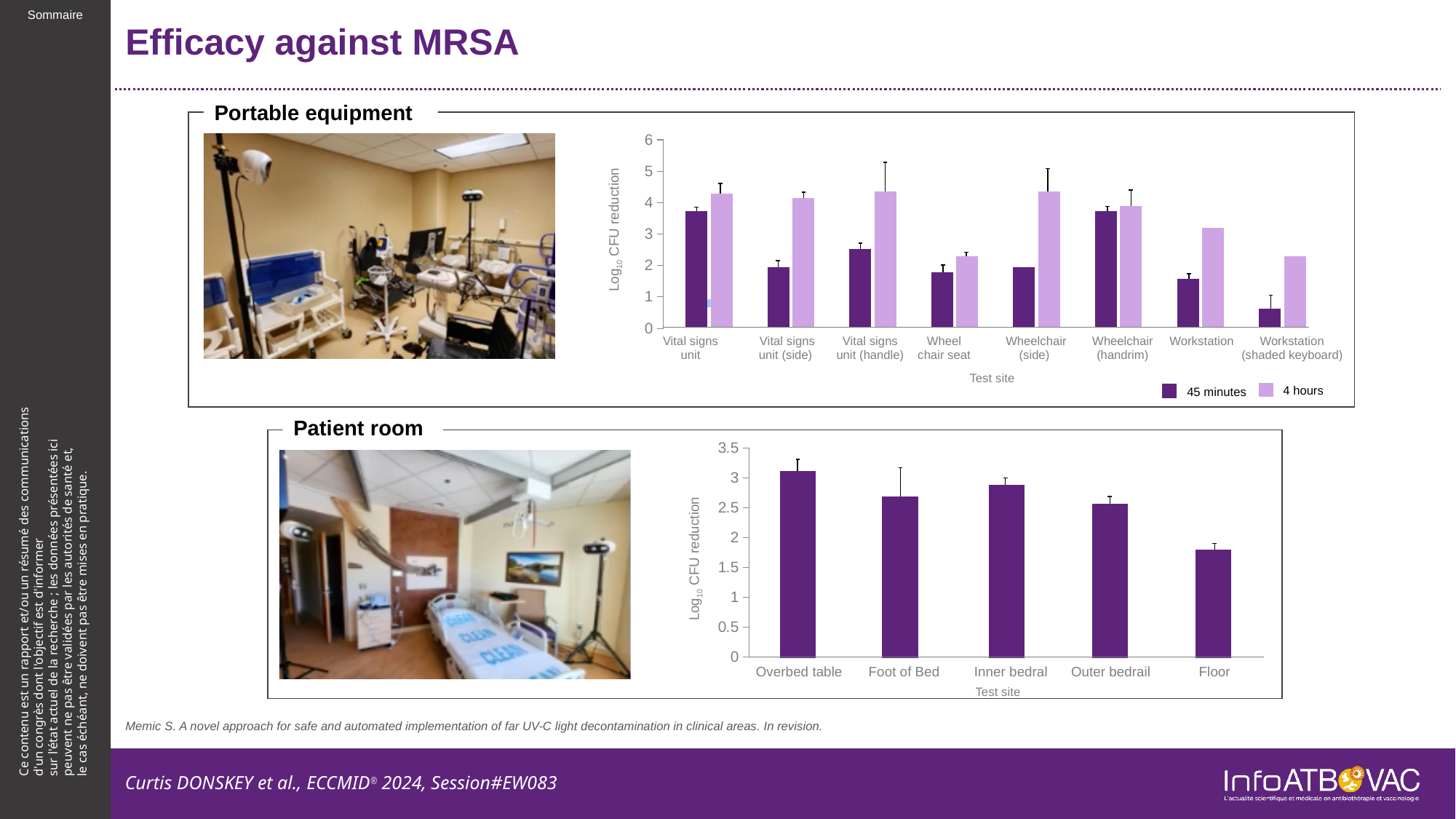
In the Portable equipment chart, which test site has the lowest value for the 45 minutes series? Workstation (shaded keyboard) In the Portable equipment chart, for Workstation, which series has the larger value: 45 minutes or 4 hours? 4 hours In the Portable equipment chart, is the 45 minutes value for Workstation (shaded keyboard) greater or less than 1? less In the Patient room chart, which is larger: the value for Overbed table or the value for Floor? Overbed table In the Patient room chart, which test site has the lowest Log10 CFU reduction? Floor What kind of chart is the Patient room chart? Bar chart In the Patient room chart, is the value for Floor greater or less than 2? less In the Portable equipment chart, how many test sites are shown on the x axis? 8 In the Portable equipment chart, is the 45 minutes value for Wheel chair seat greater or less than 2? less In the Patient room chart, how many test sites are shown? 5 In the Portable equipment chart, how many series does the legend list? 2